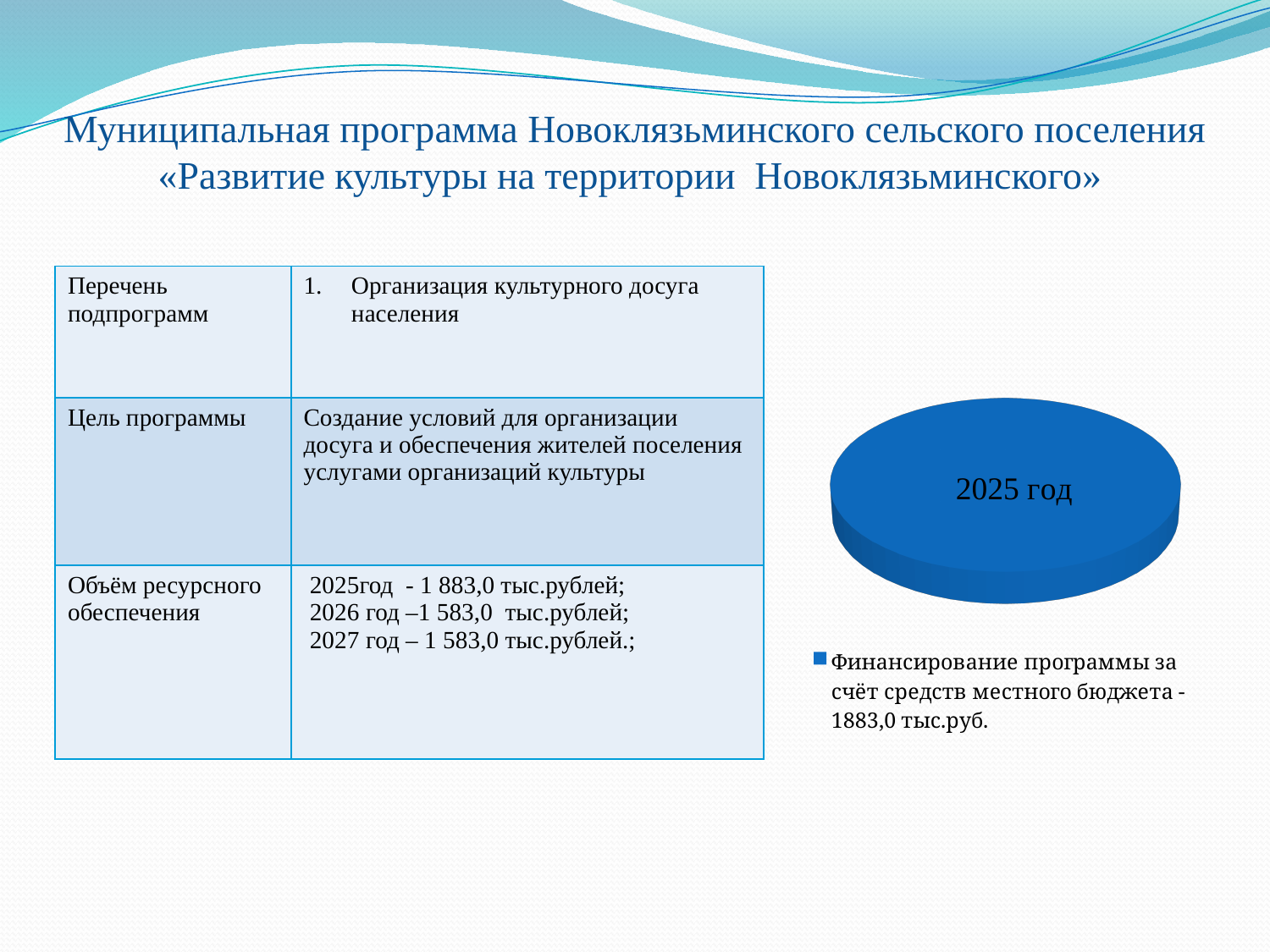
How many slices does the pie chart contain? 1 What is the legend entry of the pie chart? Финансирование программы за счёт средств местного бюджета - 1883,0 тыс.руб. What label is printed on the slice of the pie chart? 2025 год According to the legend of the pie chart, what is the amount of programme financing from the local budget? 1883,0 тыс.руб. How many entries does the legend of the pie chart list? 1 What share of the pie chart does the single slice occupy? 100% Is the value shown in the pie chart legend (1883,0 тыс.руб.) greater or less than 1500? greater What kind of chart is shown on the right side of the slide? pie chart